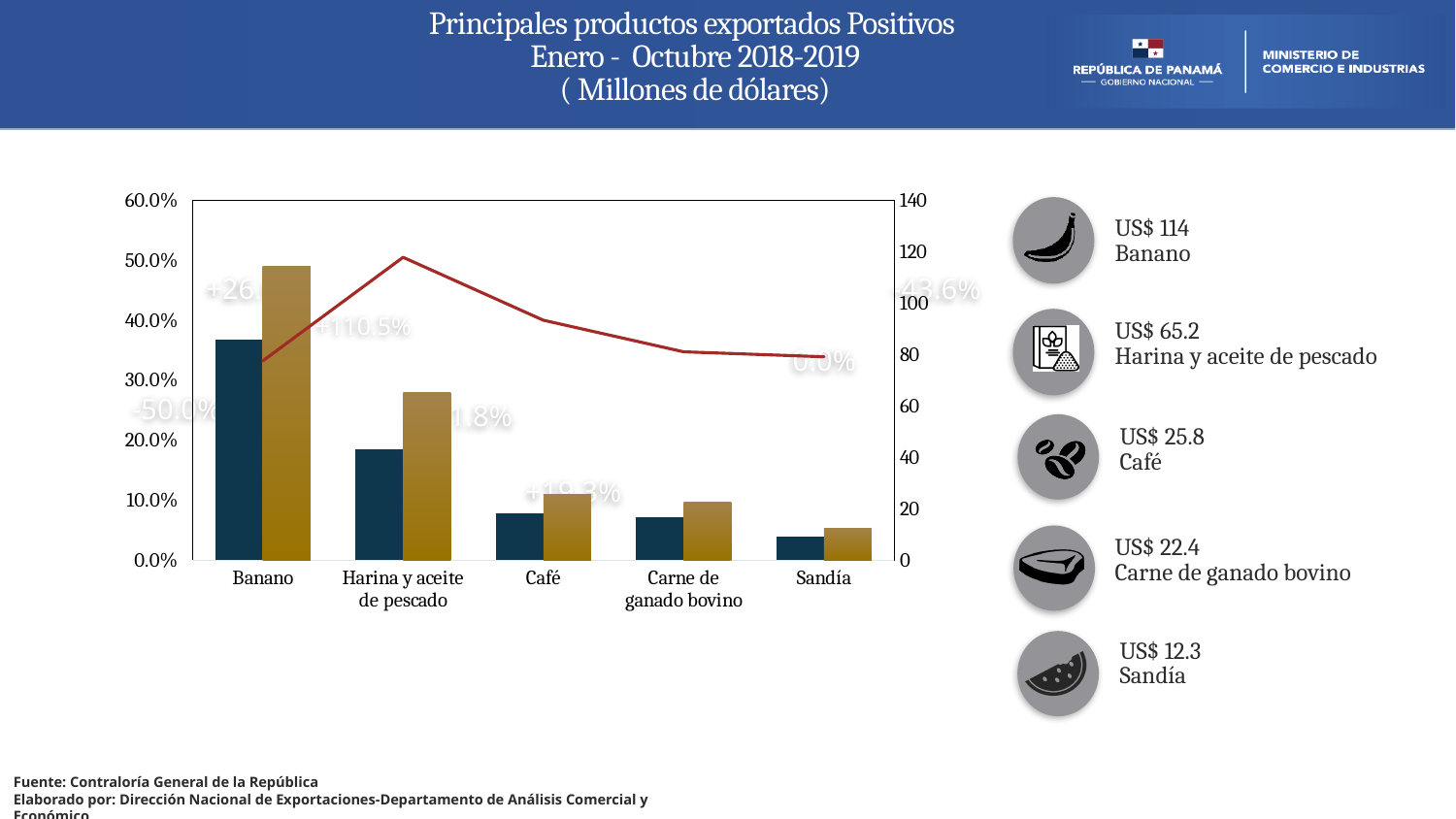
According to the values listed beside the chart, what is the export value for Harina y aceite de pescado? US$ 65.2 On the left axis, is the dark blue bar for Banano greater or less than 30.0%? greater Does the red line rise or fall from Harina y aceite de pescado to Sandía? fall How many product categories are shown on the x axis of the chart? 5 Which product has taller bars, Harina y aceite de pescado or Café? Harina y aceite de pescado According to the values listed beside the chart, what is the export value for Carne de ganado bovino? US$ 22.4 Which product has the tallest bars in the chart? Banano What unit does the chart title say the values are in? Millones de dólares What kind of chart is shown on the slide? bar chart with a line On the left axis, is the dark blue bar for Harina y aceite de pescado greater or less than 20.0%? less Which product has the shortest bars in the chart? Sandía What is the highest tick value shown on the right-hand axis of the chart? 140